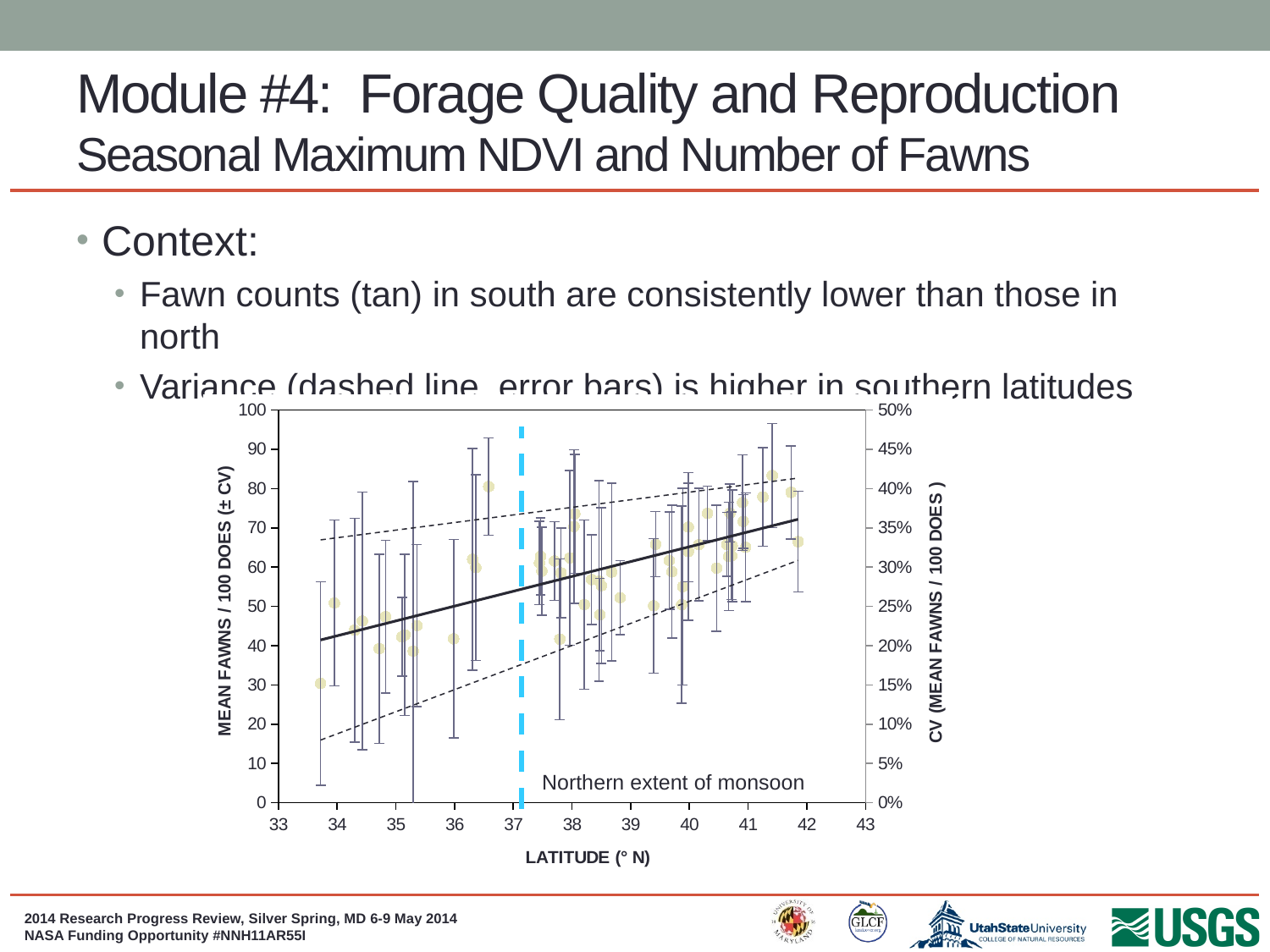
According to the solid trend line, do mean fawns per 100 does rise or fall as latitude increases? rise What is the highest value shown on the right y axis of the chart? 50% Is the mean fawns value for the leftmost data point (near latitude 33.7) greater or less than 40? less What is the label of the left y axis of the chart? MEAN FAWNS / 100 DOES (± CV) What is the highest latitude value shown on the x axis of the chart? 43 What is the label of the x axis of the chart? LATITUDE (° N) Is the mean fawns value for the highest data point near latitude 41.4 greater or less than 70? greater Is the mean fawns value for the data point near latitude 36.6 greater or less than 70? greater What is the highest value shown on the left y axis of the chart? 100 What kind of chart is shown on the slide? scatter plot What is the lowest latitude value shown on the x axis of the chart? 33 At approximately what latitude is the vertical dashed line labelled 'Northern extent of monsoon' placed: between 37 and 38, or between 38 and 39? between 37 and 38